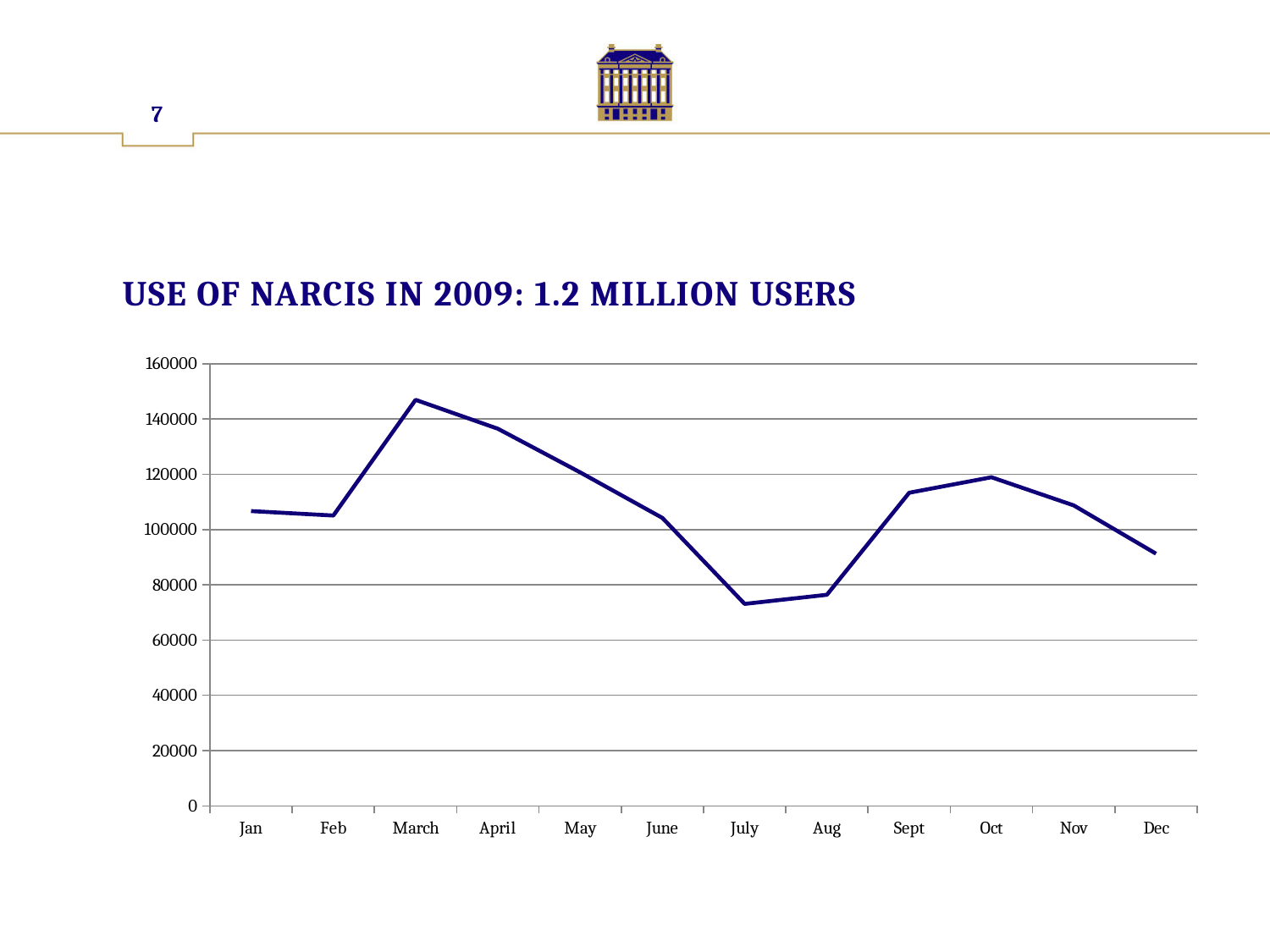
Is the value for Oct greater or less than 100000? greater Which is larger, the value for April or the value for June? April Is the value for July greater or less than 80000? less Which month has the highest value? March What is the title of the slide above the chart? USE OF NARCIS IN 2009: 1.2 MILLION USERS What kind of chart is shown on the slide? line chart Is the value for Dec greater or less than 100000? less How many months are plotted along the x axis? 12 Which month has the lowest value? July Which is larger, the value for Sept or the value for Aug? Sept Do the values rise or fall from March to July? fall